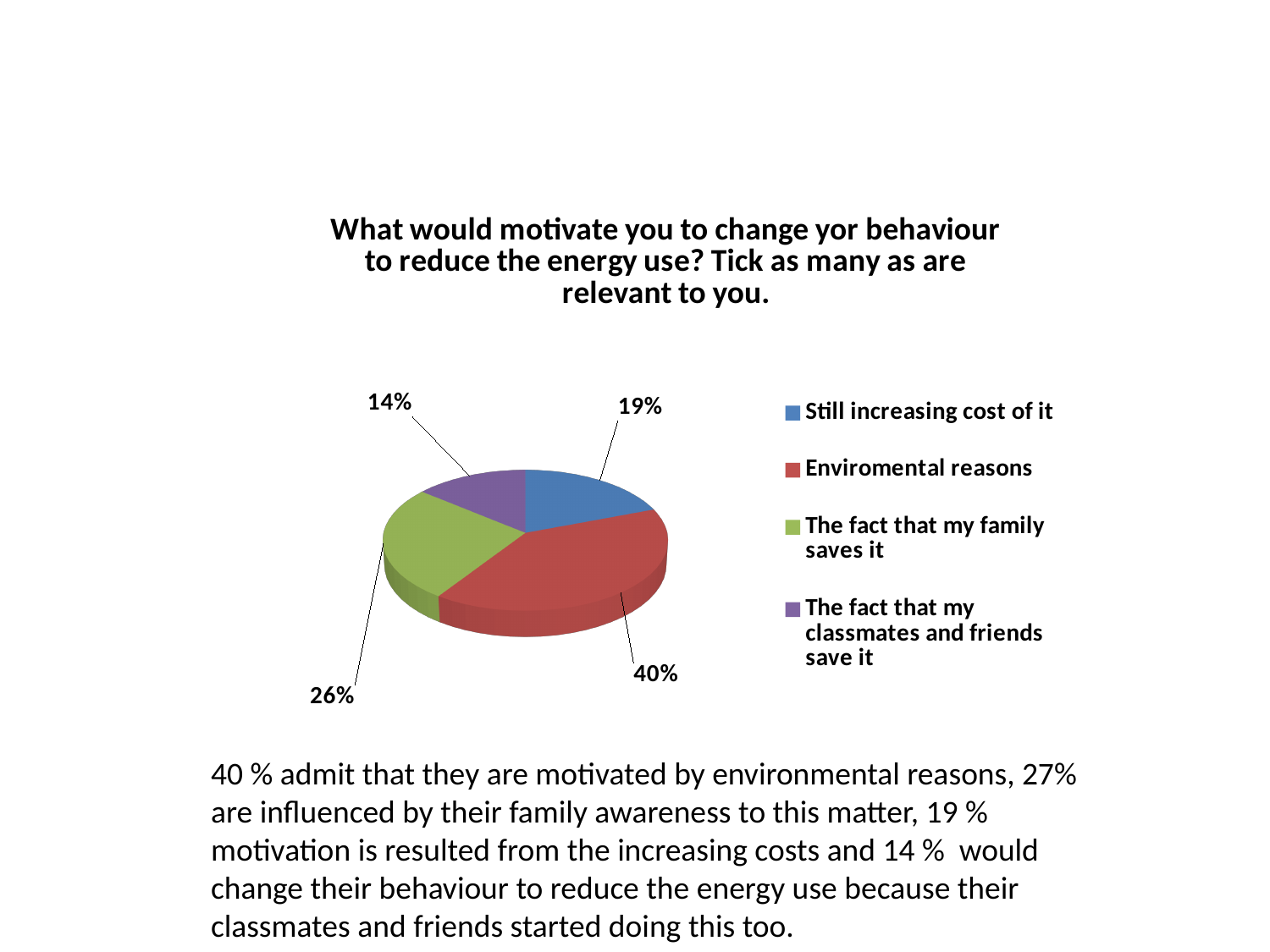
Which is larger: the slice for 'The fact that my family saves it' or the slice for 'Still increasing cost of it'? The fact that my family saves it What percentage is shown for 'The fact that my family saves it'? 26% Which category has the largest slice of the pie? Enviromental reasons How many entries does the legend list? 4 What colour is the slice for 'Enviromental reasons'? red How many slices does the pie chart have? 4 What percentage is shown for 'Still increasing cost of it'? 19% What percentage of the pie is labelled for 'Enviromental reasons'? 40% What kind of chart is shown on the slide? pie chart Which category has the smallest slice of the pie? The fact that my classmates and friends save it What percentage is shown for 'The fact that my classmates and friends save it'? 14% What is the difference in percentage points between 'Enviromental reasons' and 'Still increasing cost of it'? 21